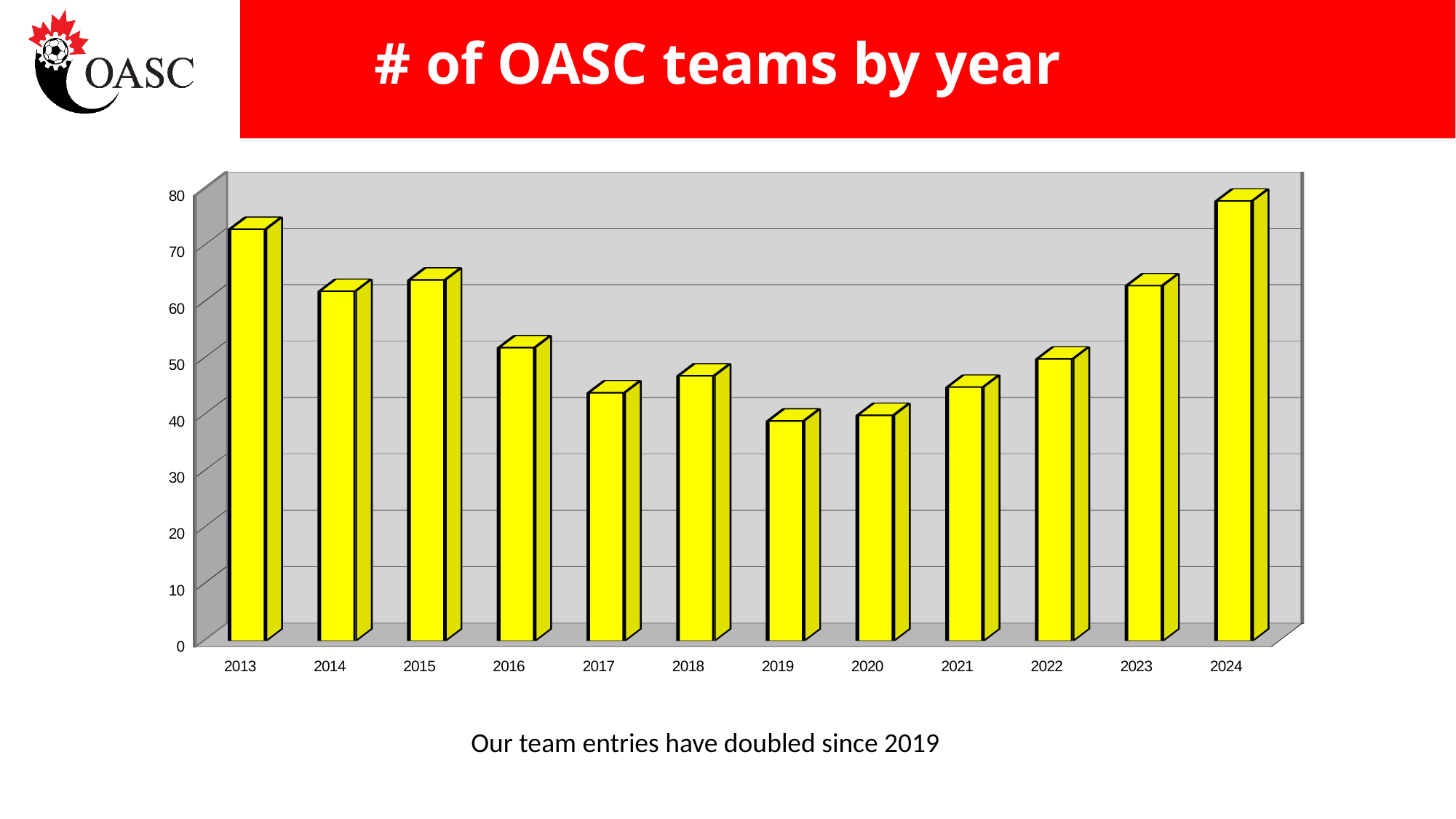
Is the value for 2017 greater or less than 50? less What kind of chart is shown on the slide? bar chart Which year has the highest number of OASC teams? 2024 Is the value for 2020 greater or less than 50? less Is the value for 2016 greater or less than 60? less What is the title of the chart? # of OASC teams by year Which year has more OASC teams, 2013 or 2014? 2013 How many years are shown on the x axis of the chart? 12 Do the values rise or fall from 2019 to 2024? rise Which year has more OASC teams, 2021 or 2022? 2022